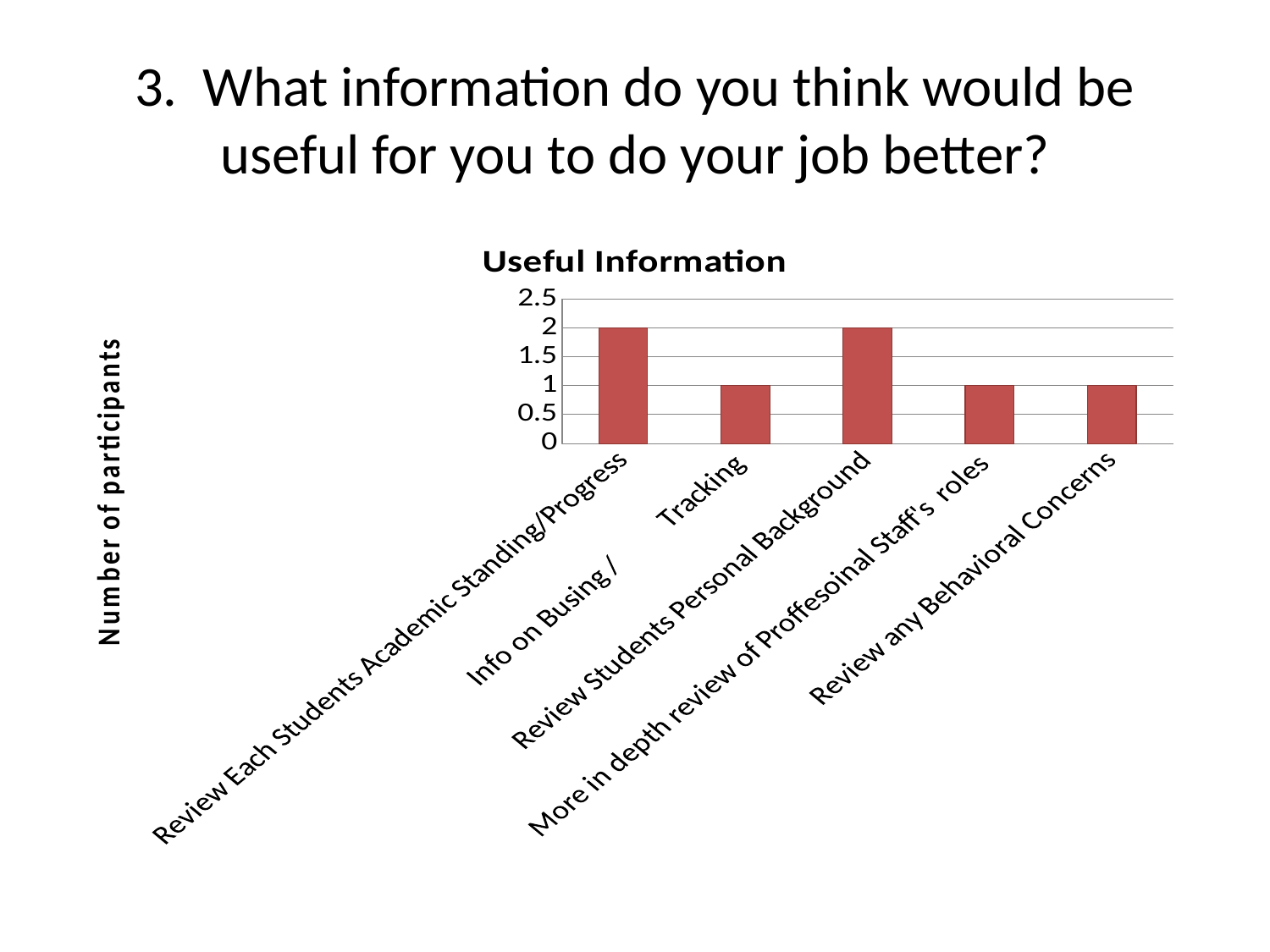
What is the value for Info on Busing / Tracking? 1 How many categories are shown in the chart? 5 Which is larger, the value for Review Each Students Academic Standing/Progress or the value for Info on Busing / Tracking? Review Each Students Academic Standing/Progress What is the label on the vertical axis of the chart? Number of participants Is the value for Review Students Personal Background greater or less than 1.5? greater What is the value for More in depth review of Proffesoinal Staff's roles? 1 What is the value for Review Students Personal Background? 2 What type of chart is shown on the slide? bar chart What is the difference between the value for Review Students Personal Background and the value for Review any Behavioral Concerns? 1 What is the value for Review any Behavioral Concerns? 1 What is the value for Review Each Students Academic Standing/Progress? 2 What is the title of the chart? Useful Information